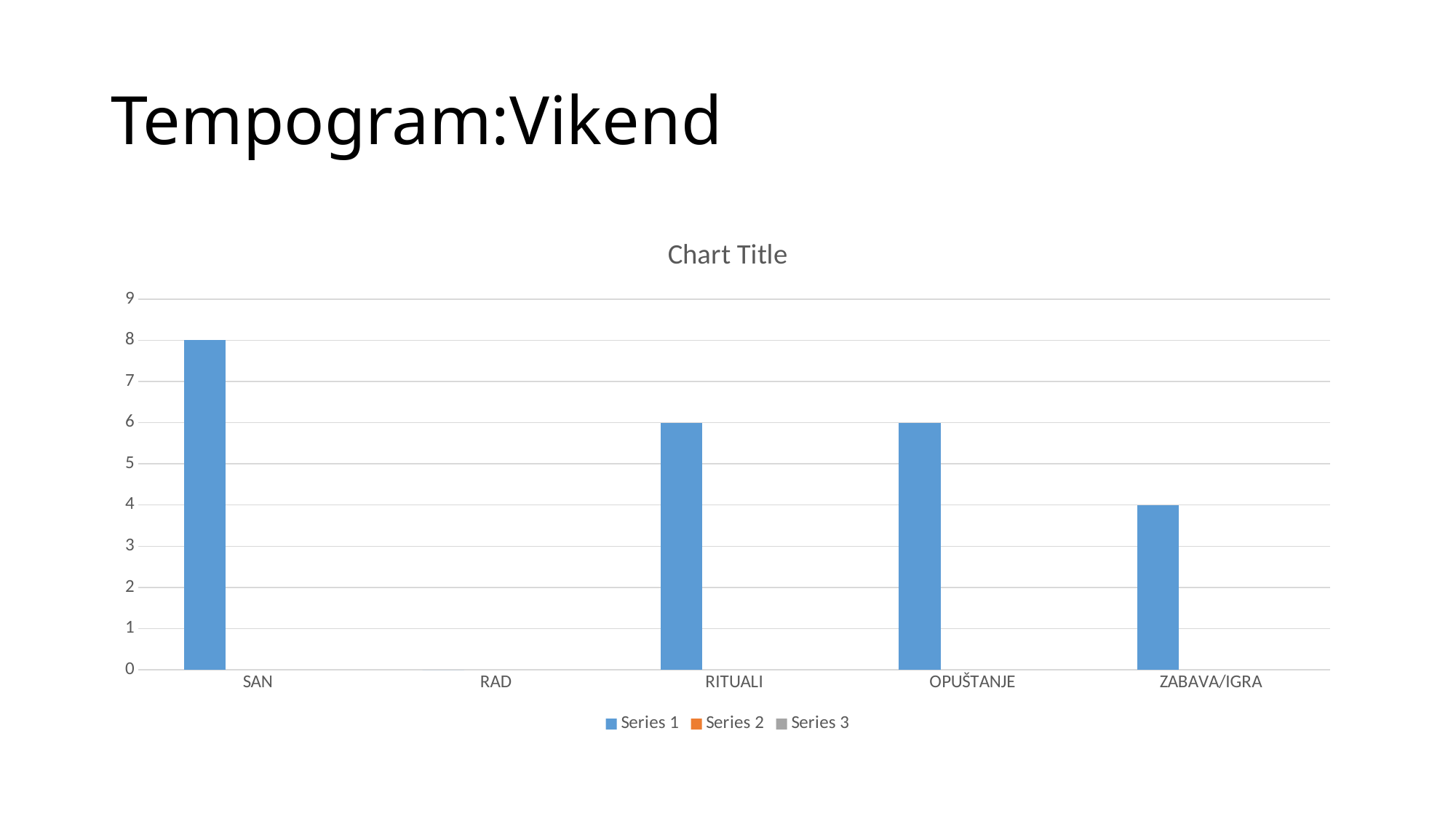
What is the value for ZABAVA/IGRA? 4 Which category has the lowest value? RAD Is the value for OPUŠTANJE greater or less than 5? greater Which is larger, the value for RITUALI or the value for ZABAVA/IGRA? RITUALI How many series does the legend list? 3 How many categories are shown on the x axis? 5 Which category has the highest value? SAN What is the title shown above the chart? Chart Title What kind of chart is shown on the slide? bar chart What is the value for RITUALI? 6 What is the difference between the values for SAN and ZABAVA/IGRA? 4 What is the value for SAN? 8